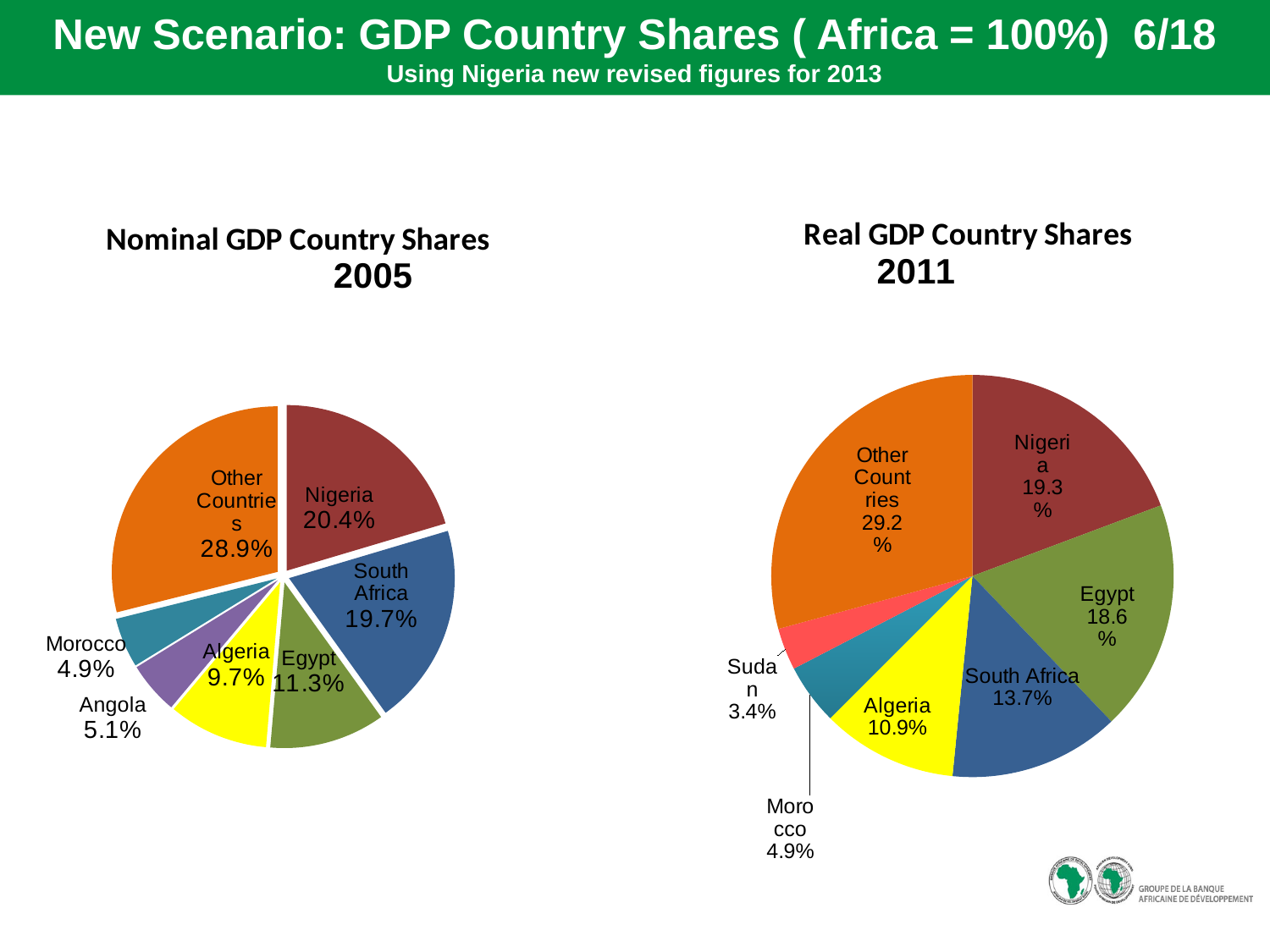
In the Real GDP Country Shares 2011 chart, what is Egypt's share? 18.6% In the Nominal GDP Country Shares 2005 chart, what is Nigeria's share? 20.4% In the Nominal GDP Country Shares 2005 chart, what is the share for South Africa? 19.7% In the Nominal GDP Country Shares 2005 chart, which named country has the smallest share? Morocco In the Nominal GDP Country Shares 2005 chart, which slice is the largest? Other Countries In the Real GDP Country Shares 2011 chart, which slice is the smallest? Sudan In the Real GDP Country Shares 2011 chart, what is the difference between Nigeria's share and South Africa's share? 5.6% What kind of charts are shown on the slide? Pie charts In the Real GDP Country Shares 2011 chart, what is the share for Sudan? 3.4% In the Nominal GDP Country Shares 2005 chart, what is the difference between Angola's share and Morocco's share? 0.2% How many slices does the Real GDP Country Shares 2011 pie chart have? 7 In the Nominal GDP Country Shares 2005 chart, which is larger, Egypt's share or Algeria's share? Egypt